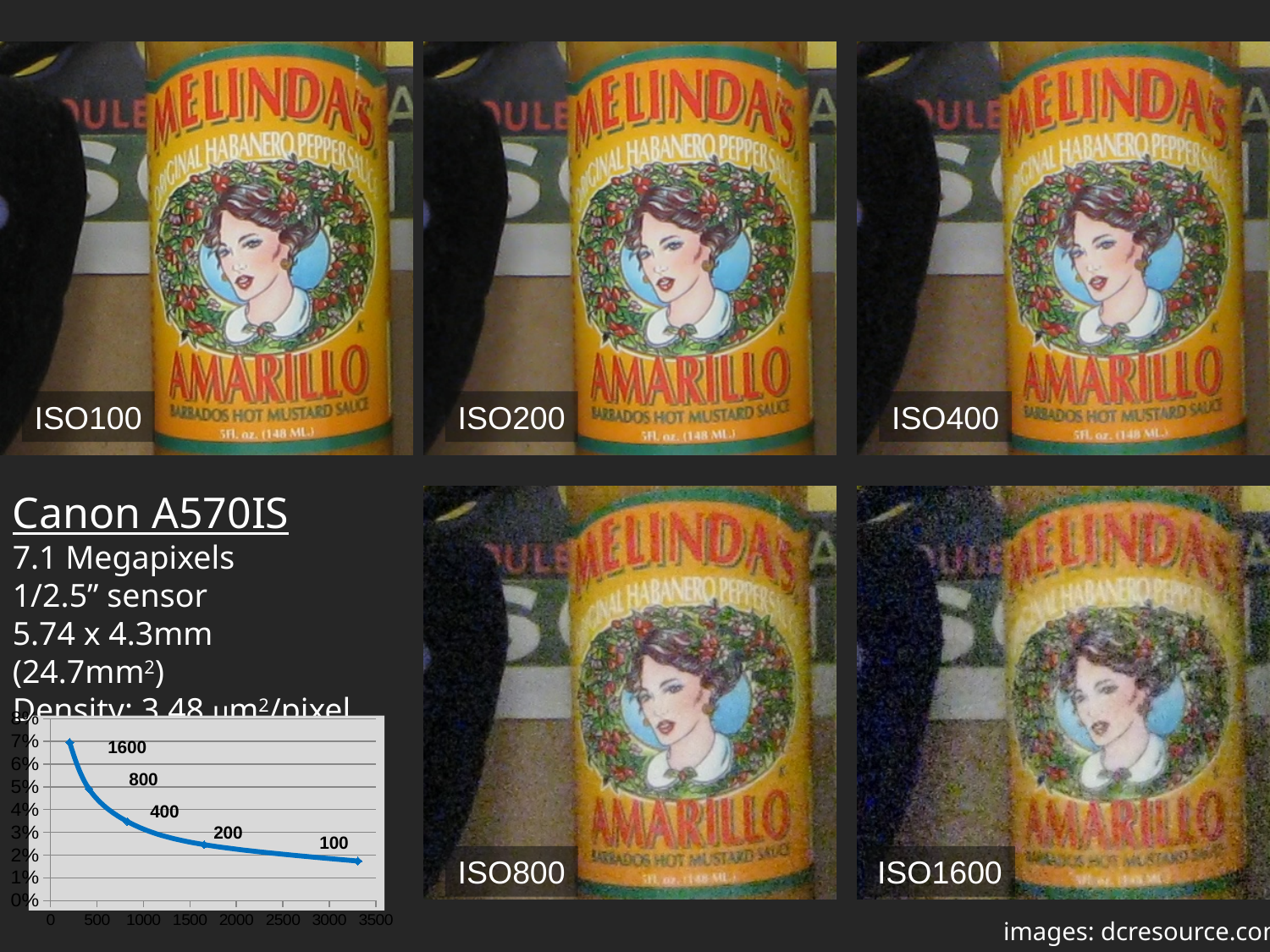
On the line chart, which has the larger value: the point labelled 1600 or the point labelled 400? 1600 Do the values on the line chart rise or fall as you move from left to right along the x axis? fall Which labelled point on the line chart has the lowest value? 100 Is the value for the point labelled 100 on the line chart greater or less than 3%? less On the line chart, which has the larger value: the point labelled 800 or the point labelled 200? 800 Is the value for the point labelled 400 on the line chart greater or less than 5%? less Is the value for the point labelled 1600 on the line chart greater or less than 6%? greater What is the highest value shown on the x axis of the line chart? 3500 How many labelled data points are plotted on the line chart? 5 Which labelled point on the line chart has the highest value? 1600 What is the highest value shown on the y axis of the line chart? 8% What kind of chart is shown at the bottom left of the slide? line chart